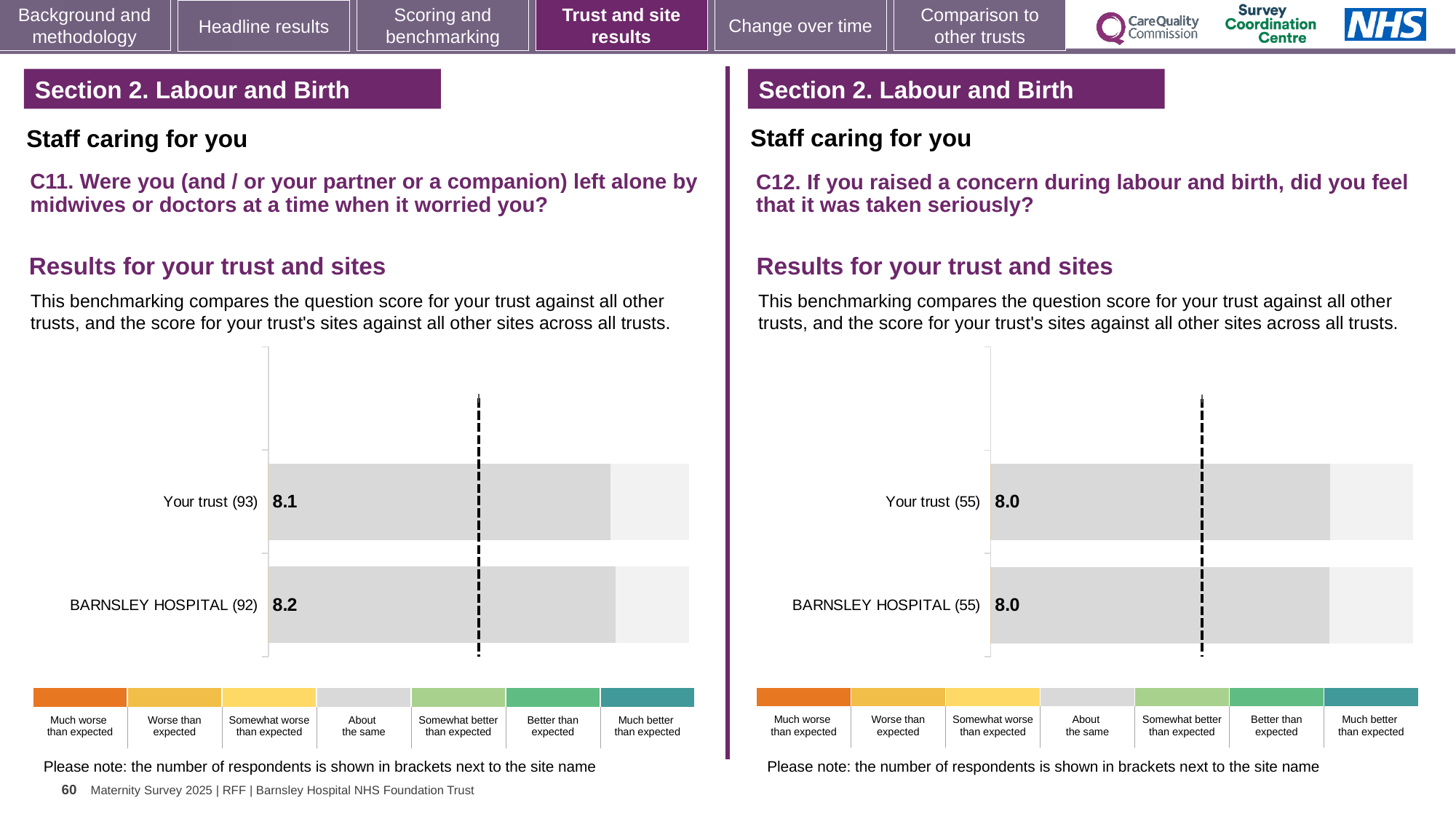
How many bars are plotted on the C11 chart (left)? 2 On the C12 chart (right), what is the difference between the Your trust score and the BARNSLEY HOSPITAL score? 0.0 On the C11 chart (left), how many respondents are shown in brackets for Your trust? 93 How many bars are plotted on the C12 chart (right)? 2 On the C11 chart (left), what is the score for Your trust? 8.1 On the C11 chart (left), what is the difference between the BARNSLEY HOSPITAL score and the Your trust score? 0.1 What type of chart is used for the C12 results (right)? Bar chart On the C12 chart (right), how many respondents are shown in brackets for BARNSLEY HOSPITAL? 55 On the C12 chart (right), what is the score for Your trust? 8.0 On the C11 chart (left), which has the higher score, Your trust or BARNSLEY HOSPITAL? BARNSLEY HOSPITAL On the C12 chart (right), what is the score for BARNSLEY HOSPITAL? 8.0 On the C11 chart (left), what is the score for BARNSLEY HOSPITAL? 8.2